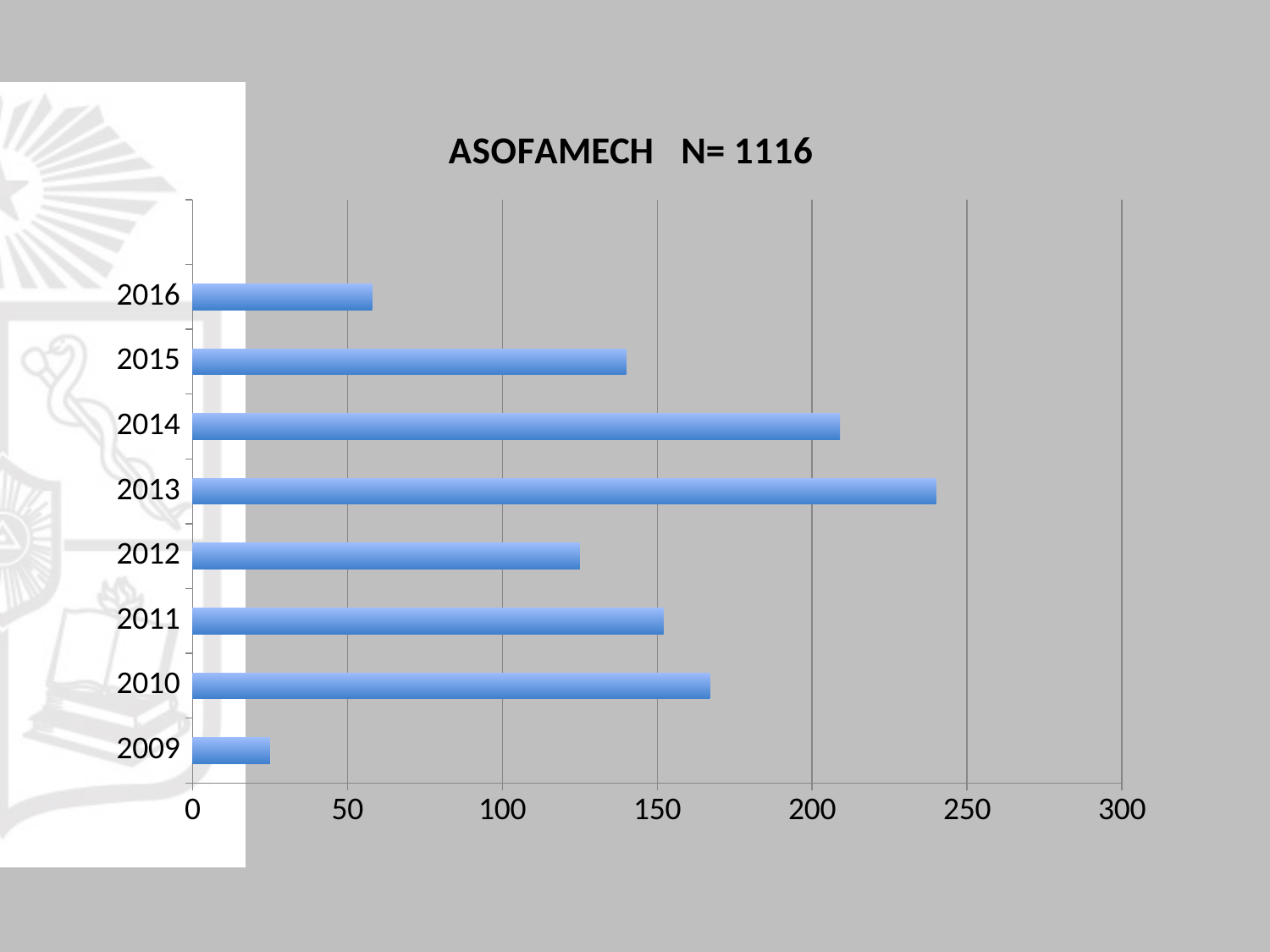
Is the value for 2012 greater or less than 100? greater Is the value for 2013 greater or less than 200? greater How many years are shown on the chart? 8 Is the value for 2009 greater or less than 50? less Which year has the larger value, 2013 or 2014? 2013 Which year has the lowest value? 2009 What type of chart is shown on the slide? bar chart Which year has the highest value? 2013 What is the title of the chart? ASOFAMECH N= 1116 Which year has the larger value, 2010 or 2011? 2010